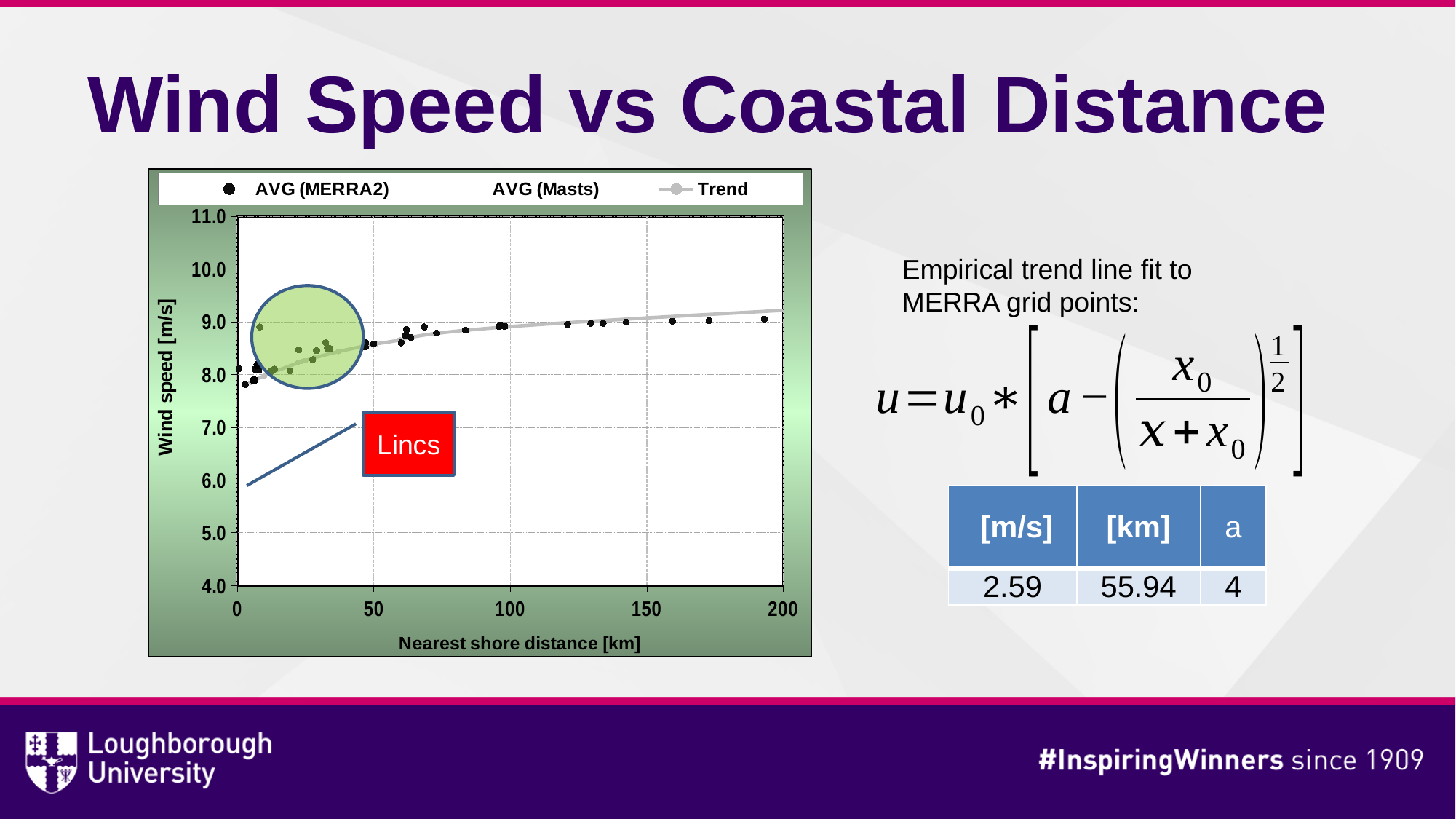
What is the label of the chart's x axis? Nearest shore distance [km] Is the wind speed for the MERRA2 points closest to 0 km greater or less than 9.0? less What kind of chart is shown on the slide? Scatter chart Which is larger: the wind speed of the MERRA2 point at about 200 km or the MERRA2 point at about 2 km? The point at about 200 km How many series does the chart legend list? 3 Is the wind speed for the points near 150 km greater or less than 8.0? greater Does the wind speed generally rise or fall as nearest shore distance increases along the x axis? Rise Is the wind speed for the points near 100 km greater or less than 10.0? less What are the three entries in the chart legend? AVG (MERRA2), AVG (Masts), Trend